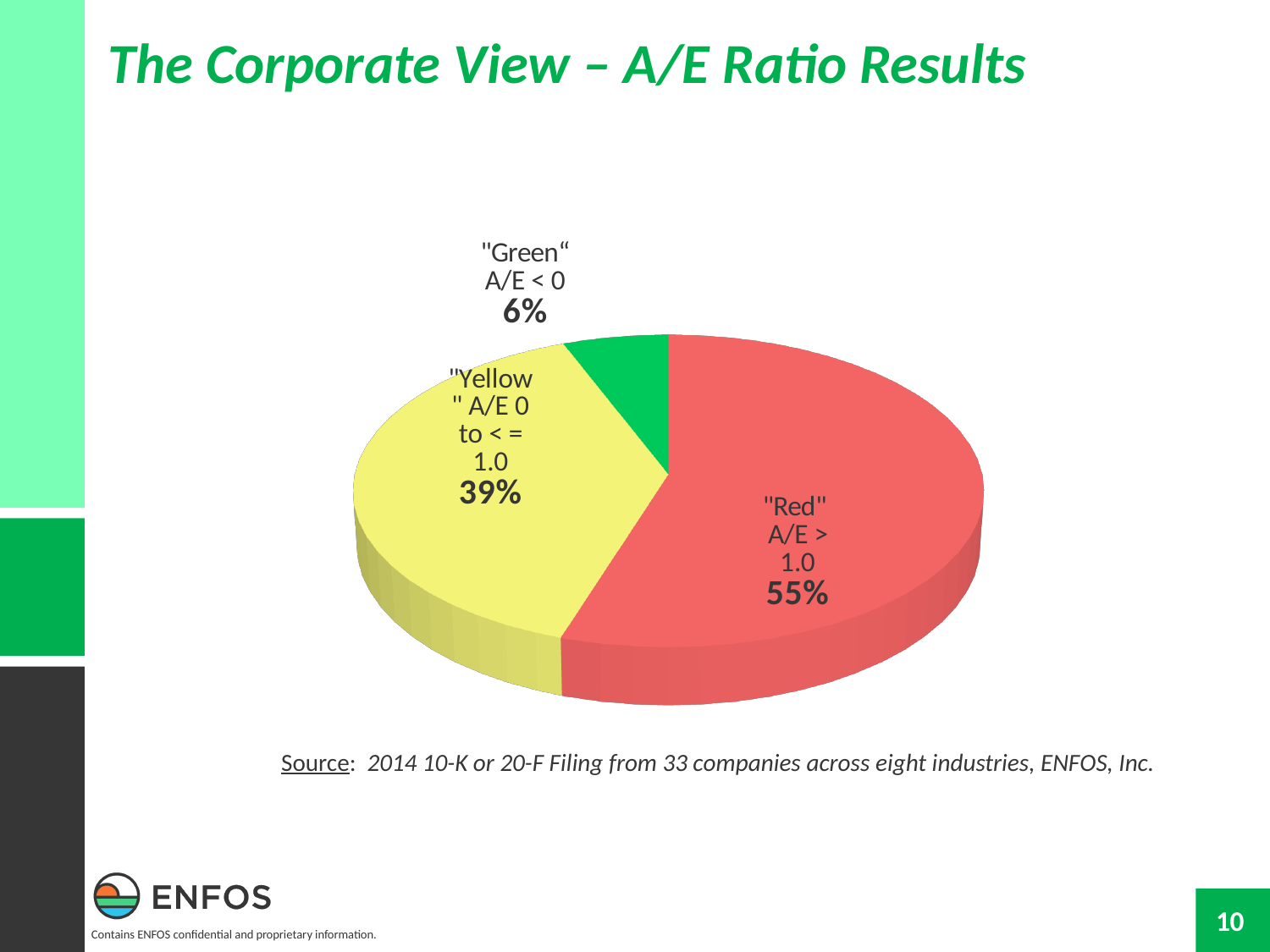
What is the difference in percentage points between the "Red" and "Yellow" slices? 16 How many slices does the pie chart have? 3 What percentage of companies fall in the "Green" A/E < 0 category? 6% What is the difference in percentage points between the "Yellow" and "Green" slices? 33 Which category has the smallest share of the pie? "Green" A/E < 0 What colour is the slice representing A/E > 1.0? Red What kind of chart is shown on the slide? Pie chart What percentage of companies fall in the "Yellow" A/E 0 to <= 1.0 category? 39% What percentage of companies fall in the "Red" A/E > 1.0 category? 55% Which category has the largest share of the pie? "Red" A/E > 1.0 Which is larger, the "Yellow" slice or the "Green" slice? "Yellow" According to the source note, how many companies were included in the data? 33